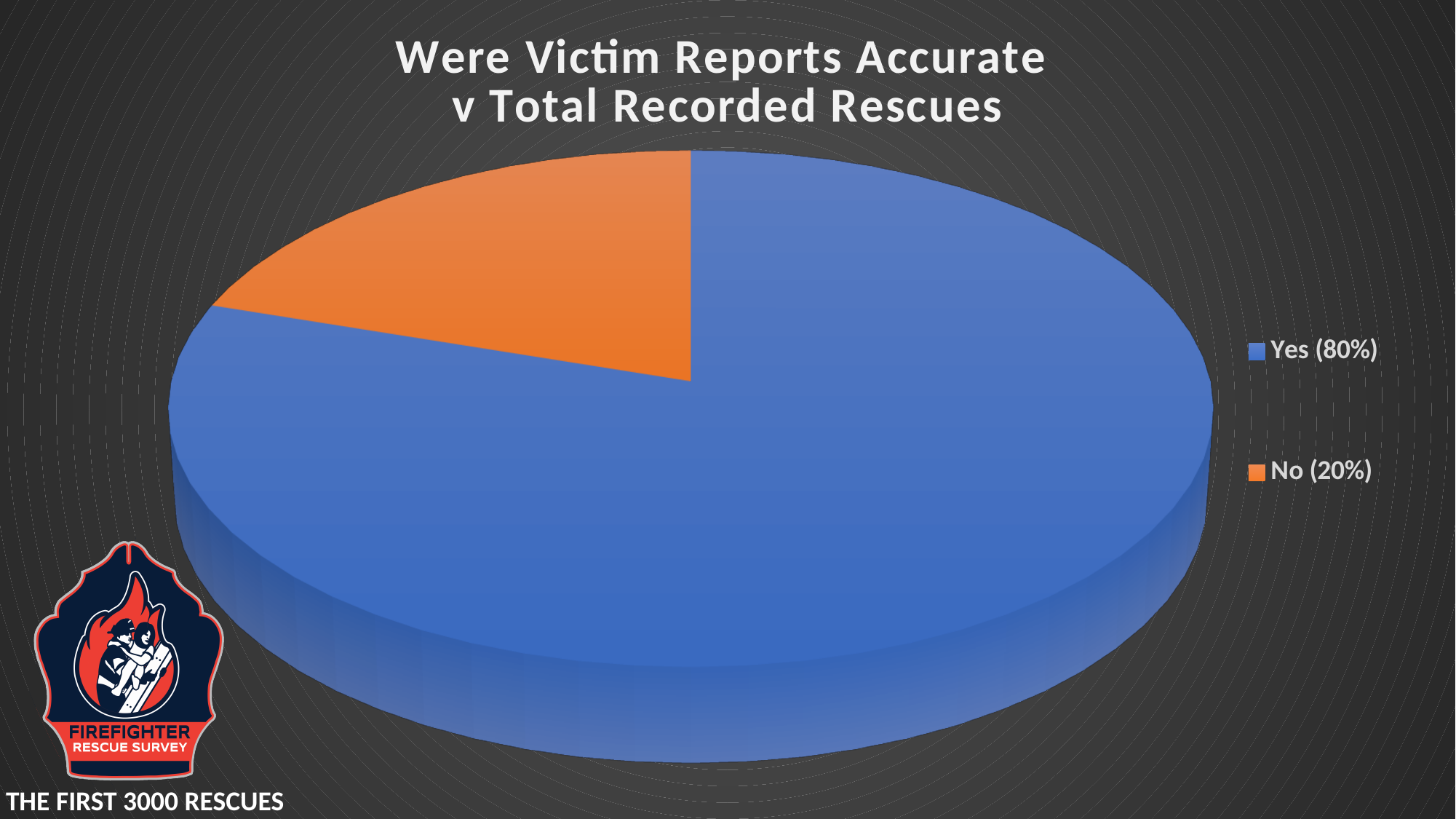
How many slices does the pie chart have? 2 Which category has the largest slice of the pie? Yes What colour is the "No" slice? orange Which is larger, the "Yes" slice or the "No" slice? Yes Which category has the smallest slice of the pie? No What is the difference in percentage points between the "Yes" and "No" slices? 60 What kind of chart is shown on the slide? pie chart What share of the pie is labelled "Yes"? 80% How many entries does the legend list? 2 What is the title of the chart? Were Victim Reports Accurate v Total Recorded Rescues What share of the pie is labelled "No"? 20%